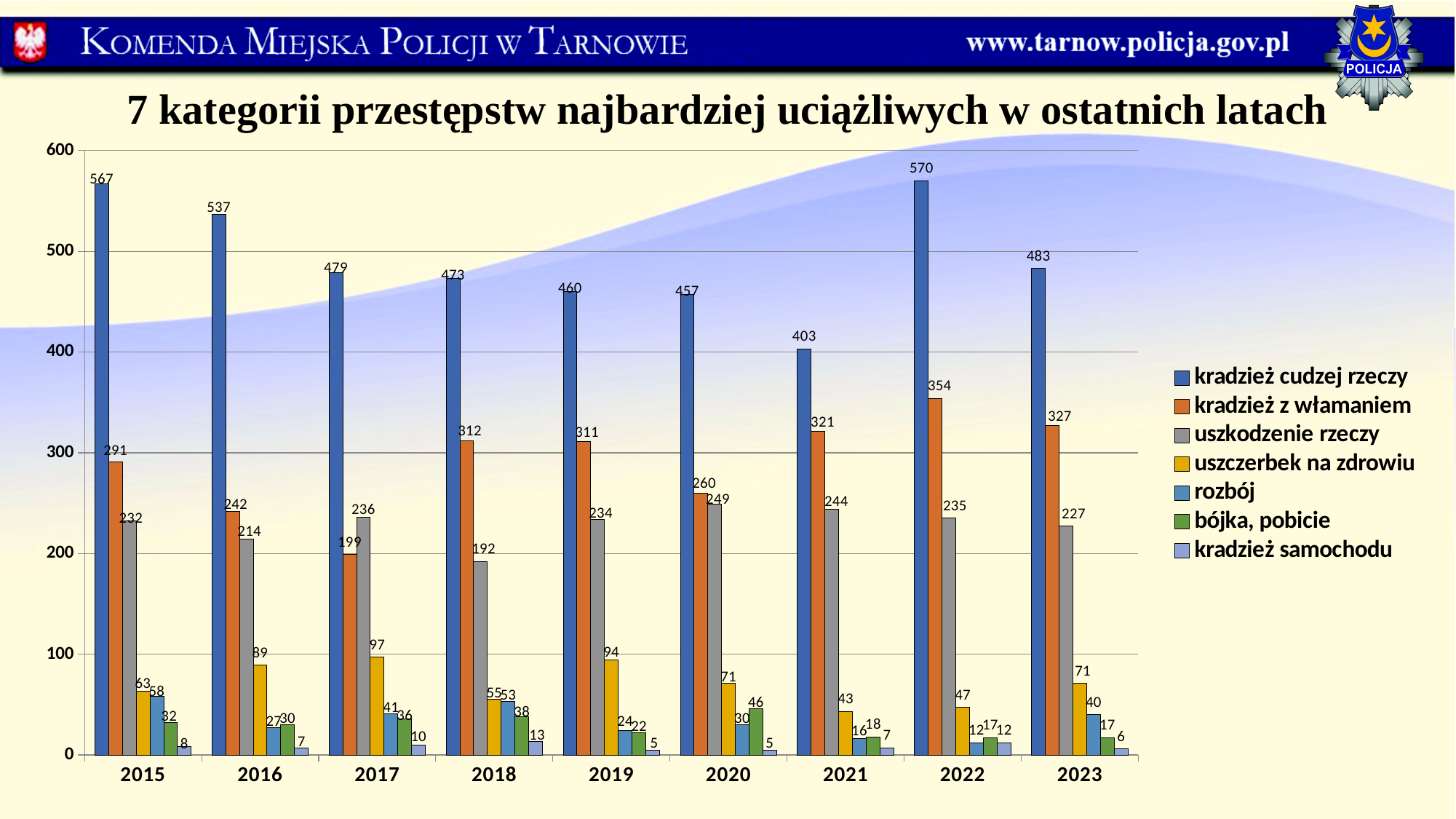
In which year is kradzież cudzej rzeczy highest? 2022 In 2017, which is larger: kradzież z włamaniem or uszkodzenie rzeczy? uszkodzenie rzeczy How many series does the legend list? 7 What is the value for kradzież samochodu in 2018? 13 What kind of chart is shown on the slide? bar chart What is the title of the chart? 7 kategorii przestępstw najbardziej uciążliwych w ostatnich latach What is the value for kradzież cudzej rzeczy in 2022? 570 How many years are shown on the x axis? 9 What is the value for uszczerbek na zdrowiu in 2019? 94 What is the difference between kradzież z włamaniem in 2022 and in 2015? 63 In which year is kradzież z włamaniem highest? 2022 In which year is kradzież cudzej rzeczy lowest? 2021